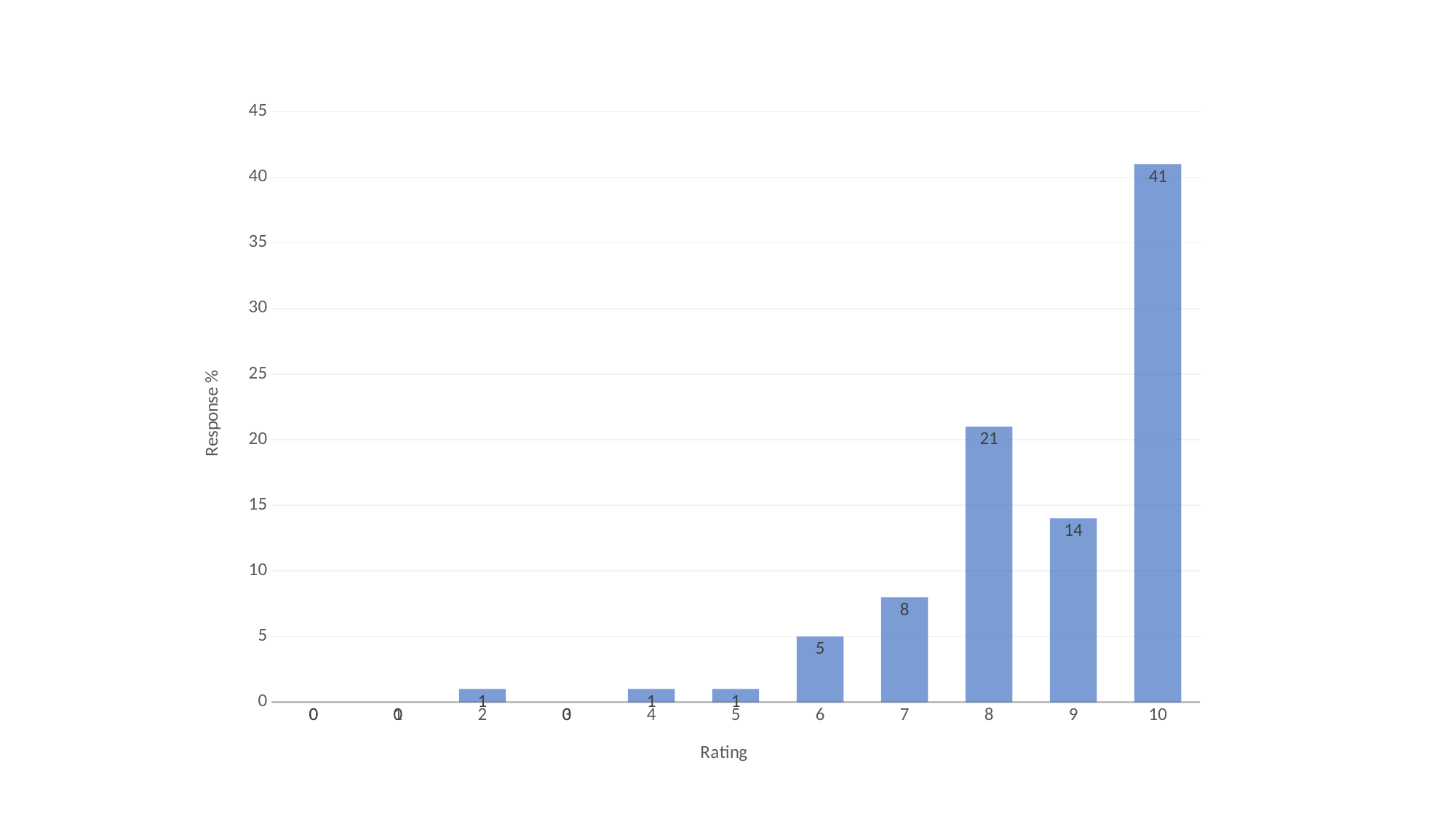
What is the response % for rating 6? 5 What is the response % for rating 8? 21 What is the response % for rating 10? 41 What kind of chart is shown on the slide? bar chart What is the difference in response % between rating 8 and rating 9? 7 What is the response % for rating 7? 8 How many rating categories are shown on the x axis? 11 What is the response % for rating 9? 14 Which rating has the highest response %? 10 What is the label of the y axis? Response % What is the difference in response % between rating 10 and rating 8? 20 Which has a larger response %, rating 9 or rating 7? rating 9